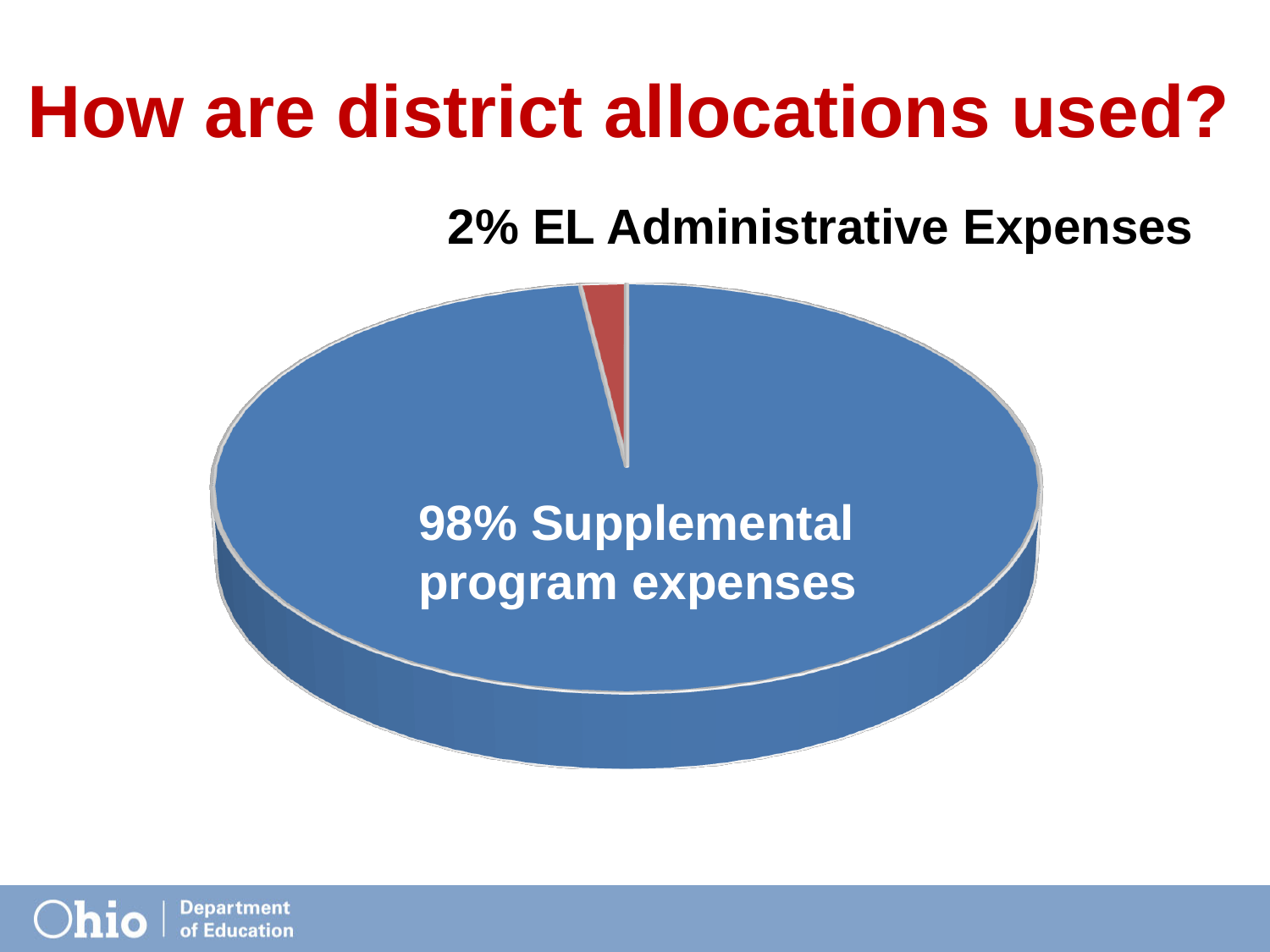
What is the difference in percentage points between Supplemental program expenses and EL Administrative Expenses? 96 Which category has the largest share of the pie? Supplemental program expenses What is the total of the two slice percentages shown? 100% What kind of chart is shown on the slide? pie chart What is the title of the slide containing the pie chart? How are district allocations used? What share of district allocations goes to EL Administrative Expenses? 2% Which category has the smallest share of the pie? EL Administrative Expenses What share of district allocations goes to Supplemental program expenses? 98% How many slices does the pie chart have? 2 Which is larger: the share for EL Administrative Expenses or the share for Supplemental program expenses? Supplemental program expenses What colour is the slice for EL Administrative Expenses? red